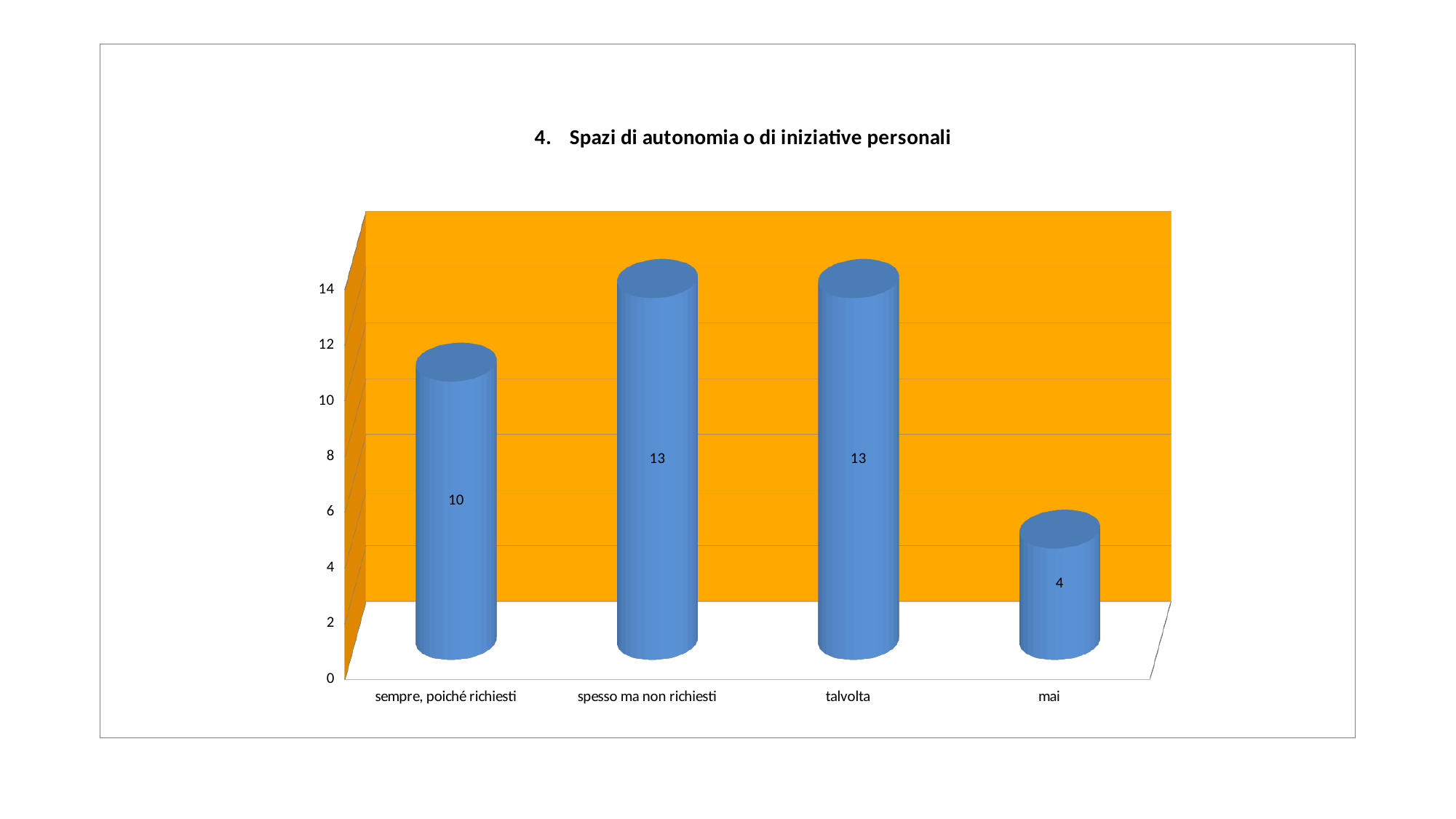
How many categories are shown on the x axis? 4 Is the value for "talvolta" greater or less than 12? greater What is the title of the chart? 4. Spazi di autonomia o di iniziative personali What is the difference between the values for "spesso ma non richiesti" and "mai"? 9 What kind of chart is shown on the slide? bar chart What is the value for "sempre, poiché richiesti"? 10 What is the difference between the values for "talvolta" and "sempre, poiché richiesti"? 3 What is the value for "talvolta"? 13 What is the value for "mai"? 4 What is the value for "spesso ma non richiesti"? 13 Which is larger, the value for "sempre, poiché richiesti" or the value for "mai"? sempre, poiché richiesti Which category has the lowest value? mai